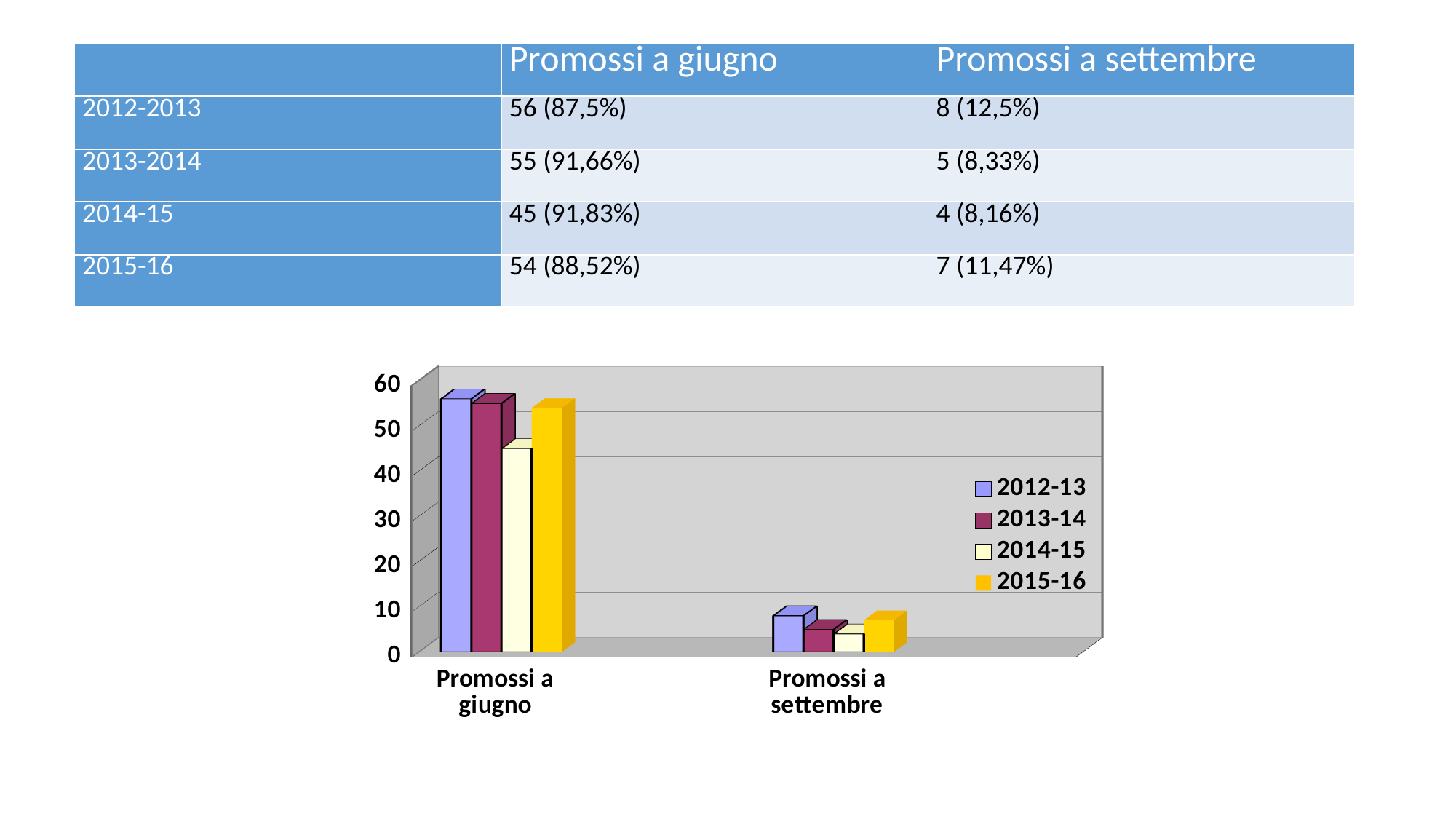
Which is larger: the 2014-15 bar or the 2015-16 bar for Promossi a giugno? 2015-16 Is the value for 2014-15 in Promossi a giugno greater or less than 50? less Which series has the highest bar for Promossi a giugno? 2012-13 Which series has the lowest bar for Promossi a settembre? 2014-15 What colour represents the 2015-16 series in the chart? yellow What kind of chart is shown on the slide? bar chart How many categories are shown on the x axis of the chart? 2 Is the value for 2015-16 in Promossi a settembre greater or less than 10? less Which series has the highest bar for Promossi a settembre? 2012-13 What is the value for 2012-13 in Promossi a giugno, as given in the table on the slide? 56 How many series does the chart legend list? 4 Which series has the lowest bar for Promossi a giugno? 2014-15